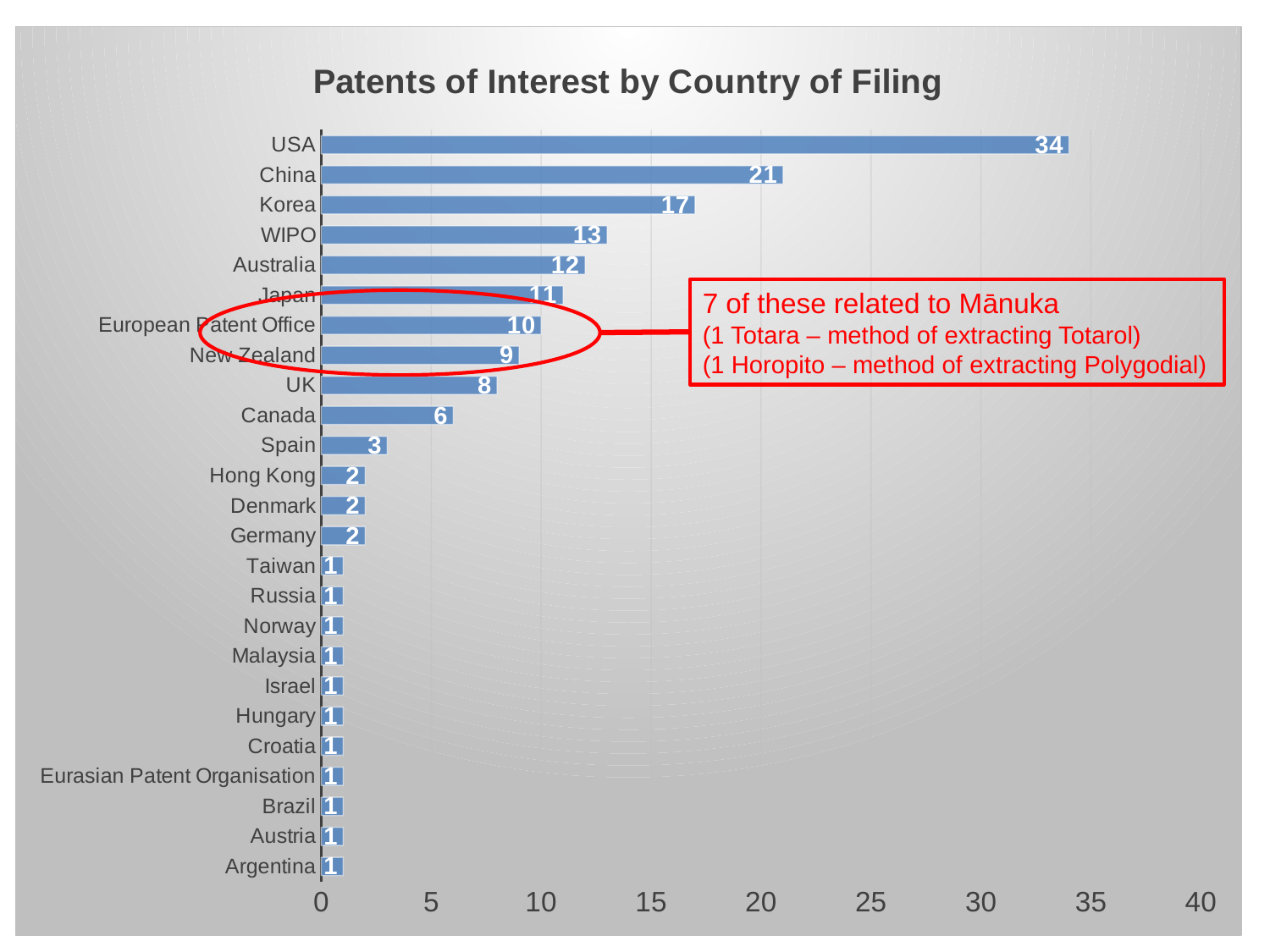
What kind of chart is shown on the slide? Bar chart Which is larger, the value for Australia or the value for Japan? Australia What is the value for Canada? 6 What is the value for the European Patent Office? 10 What is the difference between the values for USA and China? 13 How many countries or organisations are shown in the chart? 25 What is the difference between the values for Korea and WIPO? 4 What is the title of the chart? Patents of Interest by Country of Filing What is the value for USA? 34 Which country has the highest number of patents of interest? USA Is the value for China greater or less than 20? greater What is the value for New Zealand? 9